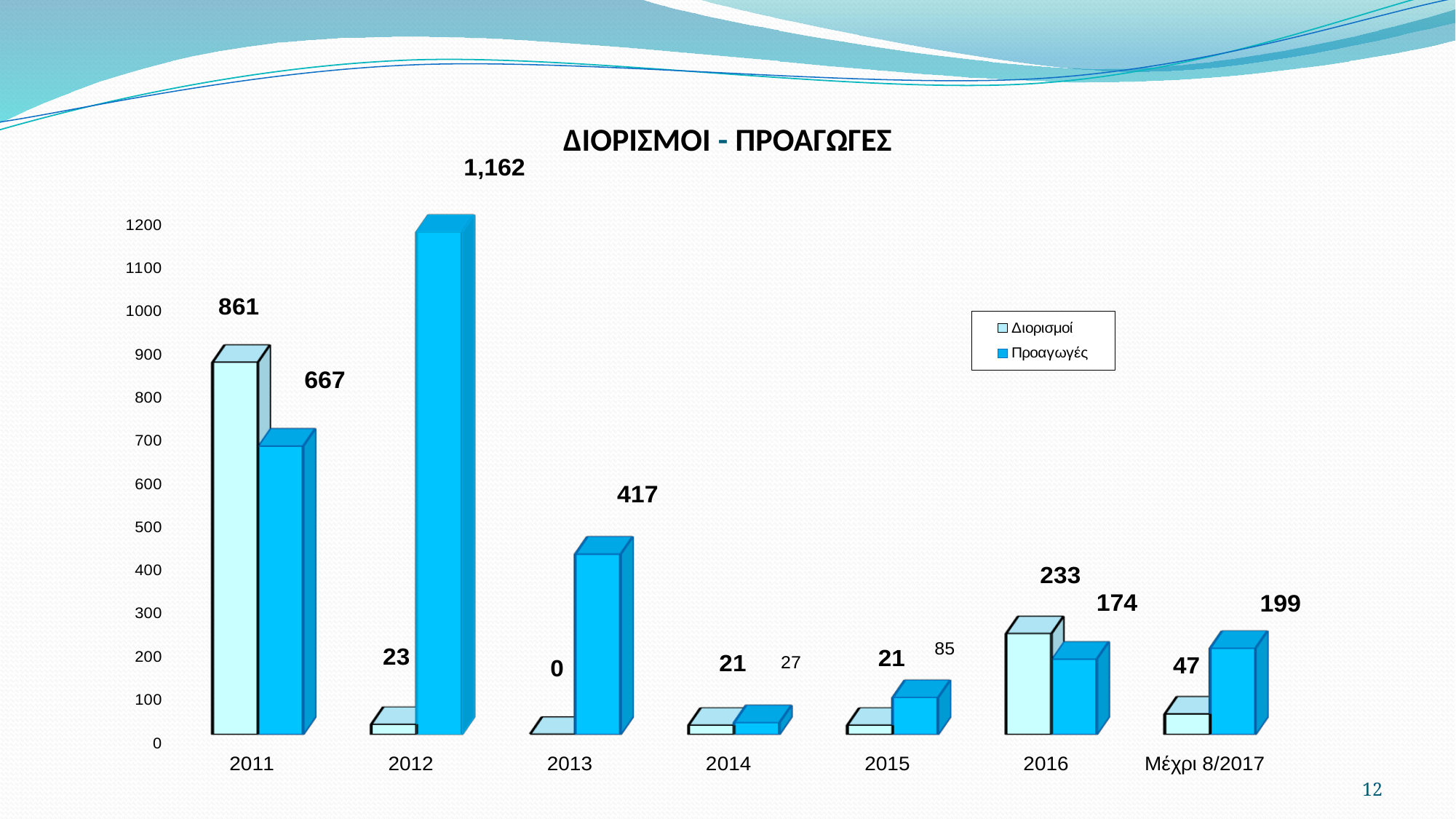
In 2015, which is larger: Διορισμοί or Προαγωγές? Προαγωγές What kind of chart is shown on the slide? Bar chart What is the value of Διορισμοί for 2011? 861 Which year has the highest value for Προαγωγές? 2012 How many categories are shown on the x axis? 7 What is the value of Διορισμοί for 2013? 0 What is the title of the chart? ΔΙΟΡΙΣΜΟΙ - ΠΡΟΑΓΩΓΕΣ What is the value of Προαγωγές for Μέχρι 8/2017? 199 Which category has the lowest value for Διορισμοί? 2013 What is the difference between Διορισμοί and Προαγωγές in 2016? 59 What is the value of Προαγωγές for 2012? 1,162 How many series does the legend list? 2